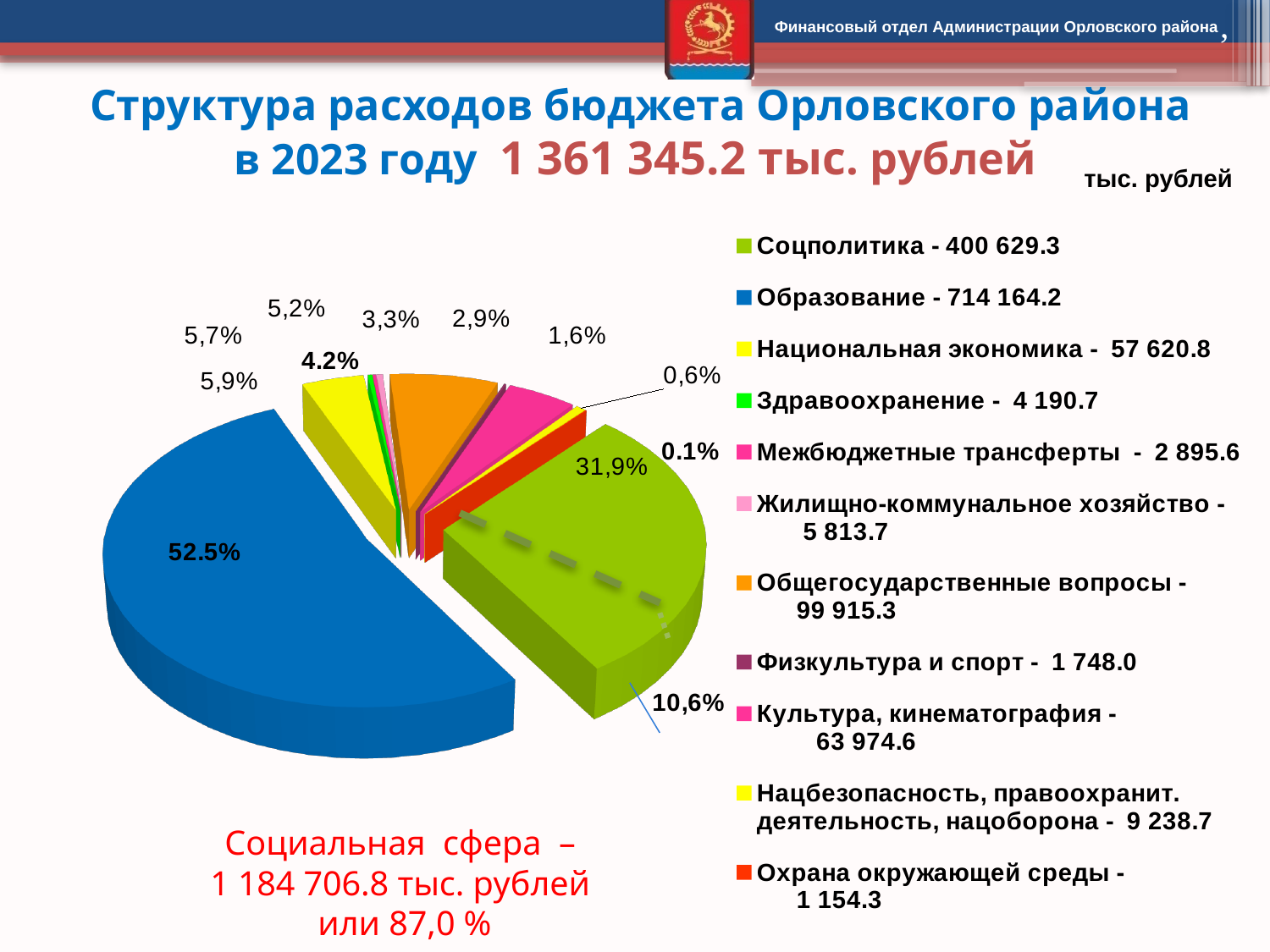
What is the value for Соцполитика shown in the legend? 400 629.3 Which is larger: the value for Национальная экономика or the value for Культура, кинематография? Культура, кинематография What is the difference between the values for Образование and Соцполитика? 313 534.9 What is the value for Общегосударственные вопросы shown in the legend? 99 915.3 What kind of chart is shown on the slide? pie chart Which category has the highest value in the pie chart? Образование What share of the pie does the Образование slice represent? 52.5% What is the difference between the values for Общегосударственные вопросы and Культура, кинематография? 35 940.7 How many categories does the legend of the pie chart list? 11 Which category has the lowest value in the pie chart? Охрана окружающей среды What is the value for Образование shown in the legend? 714 164.2 What total amount in тыс. рублей is stated in the chart title for 2023? 1 361 345.2 тыс. рублей